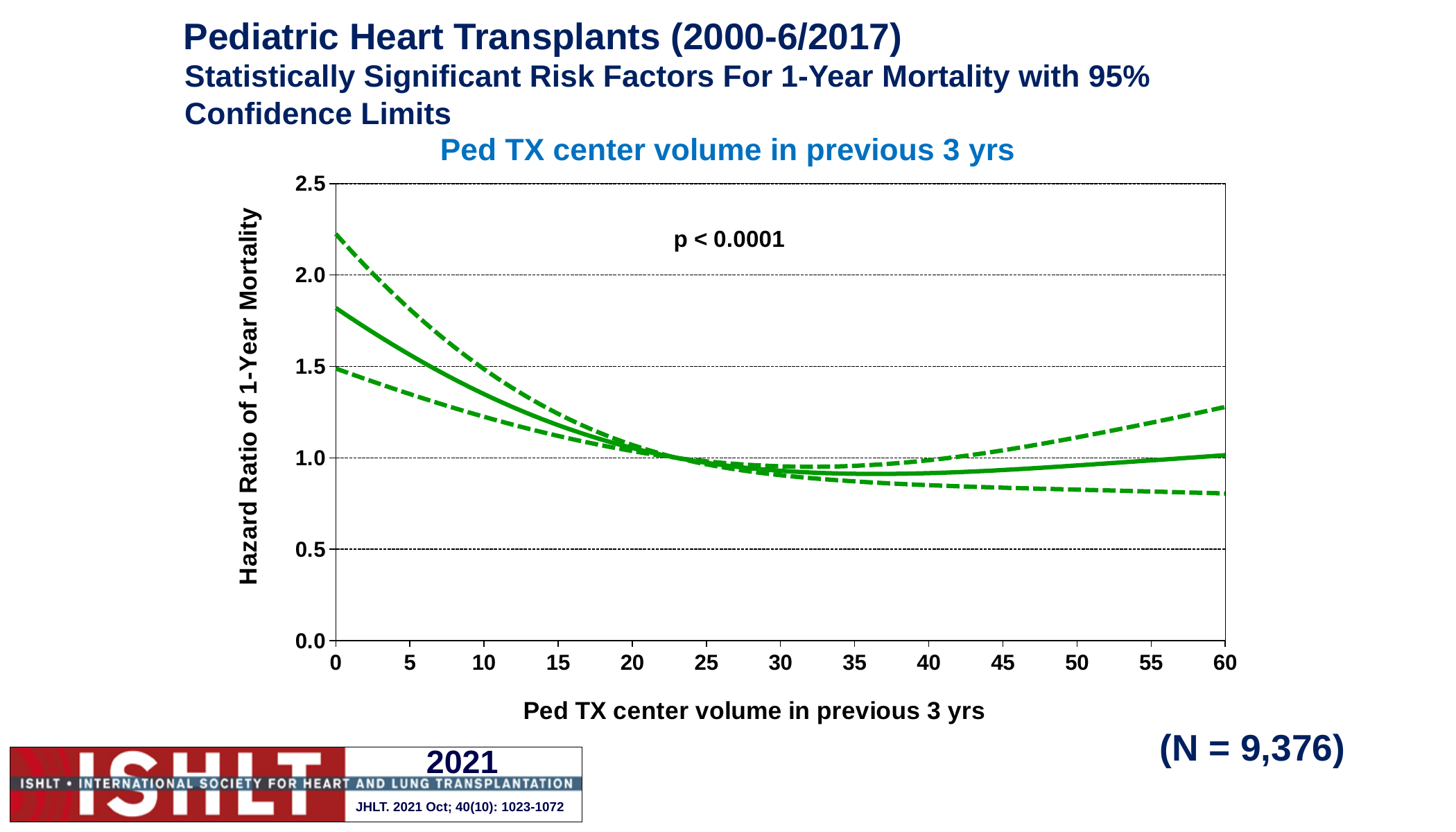
Does the solid hazard ratio line rise or fall as center volume increases from 0 to 20? fall Is the value of the upper dashed confidence limit at a center volume of 0 greater or less than 2.0? greater What is the highest value shown on the y axis? 2.5 What is the label of the y axis? Hazard Ratio of 1-Year Mortality Is the value of the upper dashed confidence limit at a center volume of 60 greater or less than 1.0? greater What p-value is printed on the chart? p < 0.0001 What kind of chart is shown on the slide? line chart Is the value of the lower dashed confidence limit at a center volume of 60 greater or less than 1.0? less How many lines are plotted on the chart? 3 What is the title of the chart? Ped TX center volume in previous 3 yrs